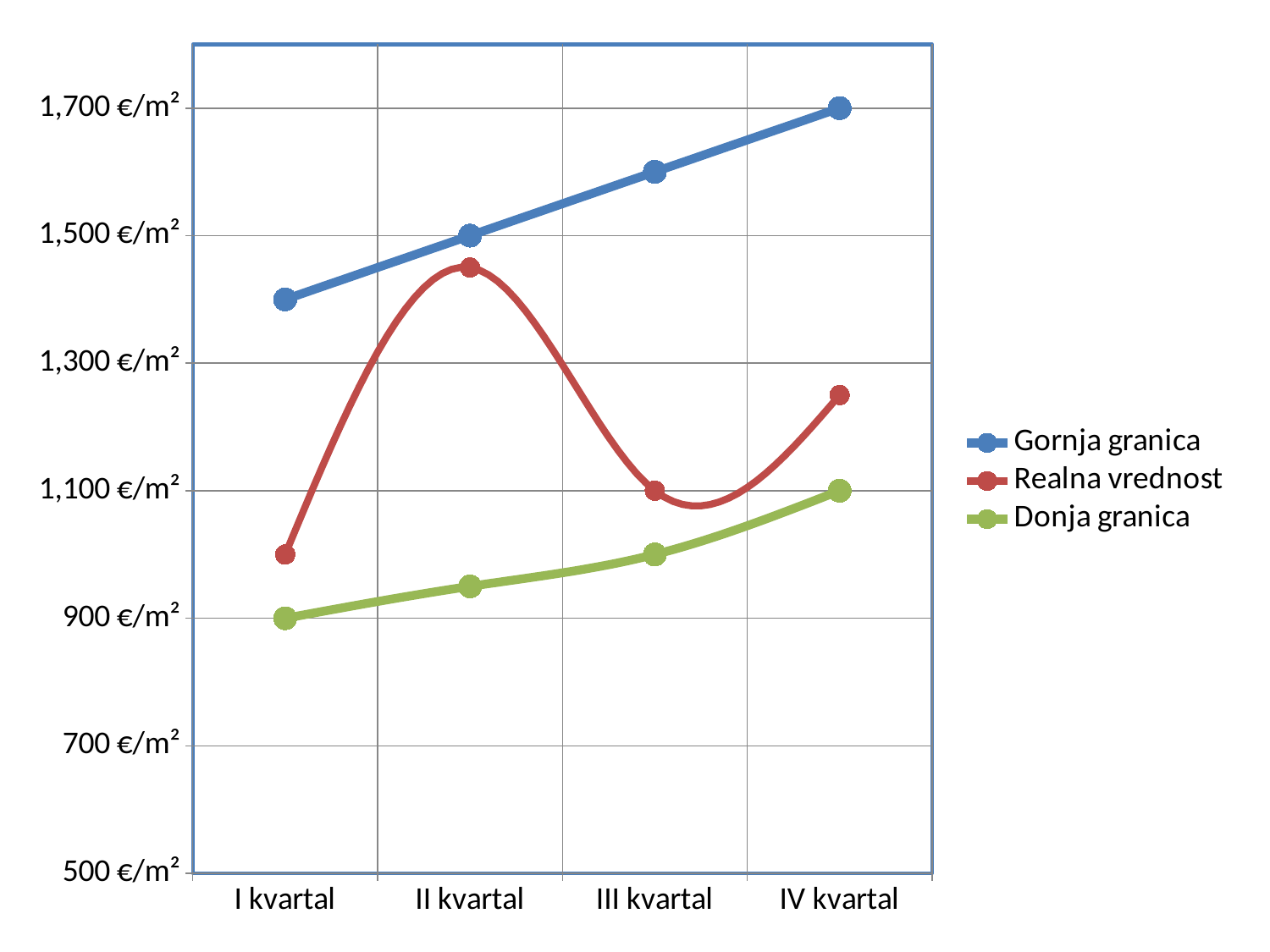
What is the value of Realna vrednost in III kvartal? 1,100 €/m² In which quarter does Realna vrednost reach its highest value? II kvartal How many categories are shown on the x axis? 4 Is the value of Realna vrednost in II kvartal greater or less than 1,300 €/m²? greater Which is larger in II kvartal, Gornja granica or Realna vrednost? Gornja granica What is the value of Donja granica in I kvartal? 900 €/m² Is the value of Realna vrednost in I kvartal greater or less than 1,100 €/m²? less What kind of chart is shown on the slide? line chart How many series does the legend list? 3 What is the value of Gornja granica in IV kvartal? 1,700 €/m² What is the value of Gornja granica in II kvartal? 1,500 €/m² Does Gornja granica rise or fall from I kvartal to IV kvartal? rise